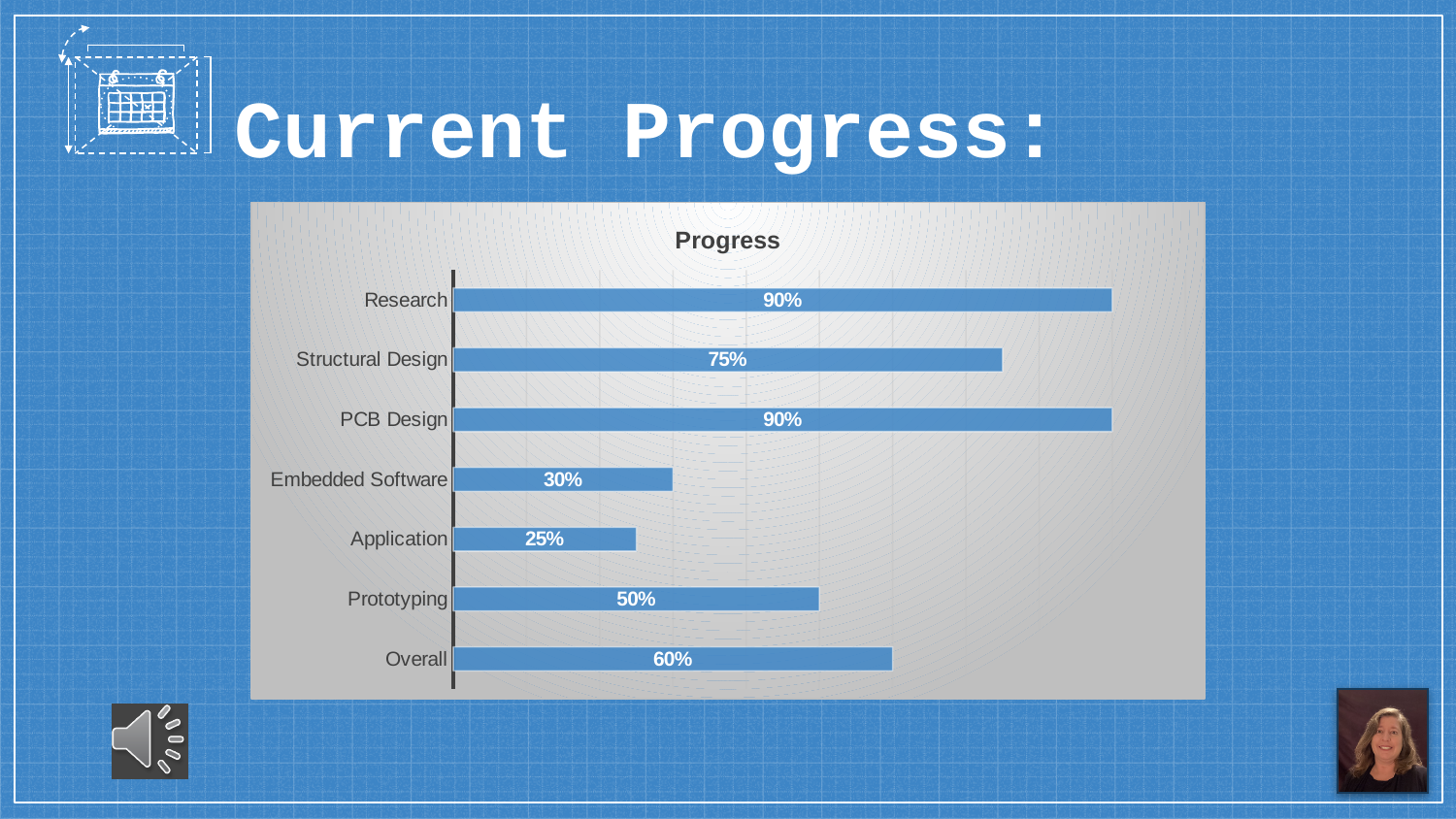
What is the progress value for Embedded Software? 30% Which two categories share the highest progress value of 90%? Research and PCB Design What is the difference between the progress values for Research and Application? 65% What is the progress value for Structural Design? 75% How many categories are shown in the chart? 7 Which has a larger progress value, Embedded Software or Application? Embedded Software What is the difference between the progress values for Prototyping and Embedded Software? 20% What is the title of the chart? Progress Which category has the lowest progress value? Application What is the progress value for Overall? 60% What kind of chart is shown on the slide? Bar chart Which has a larger progress value, Structural Design or Prototyping? Structural Design